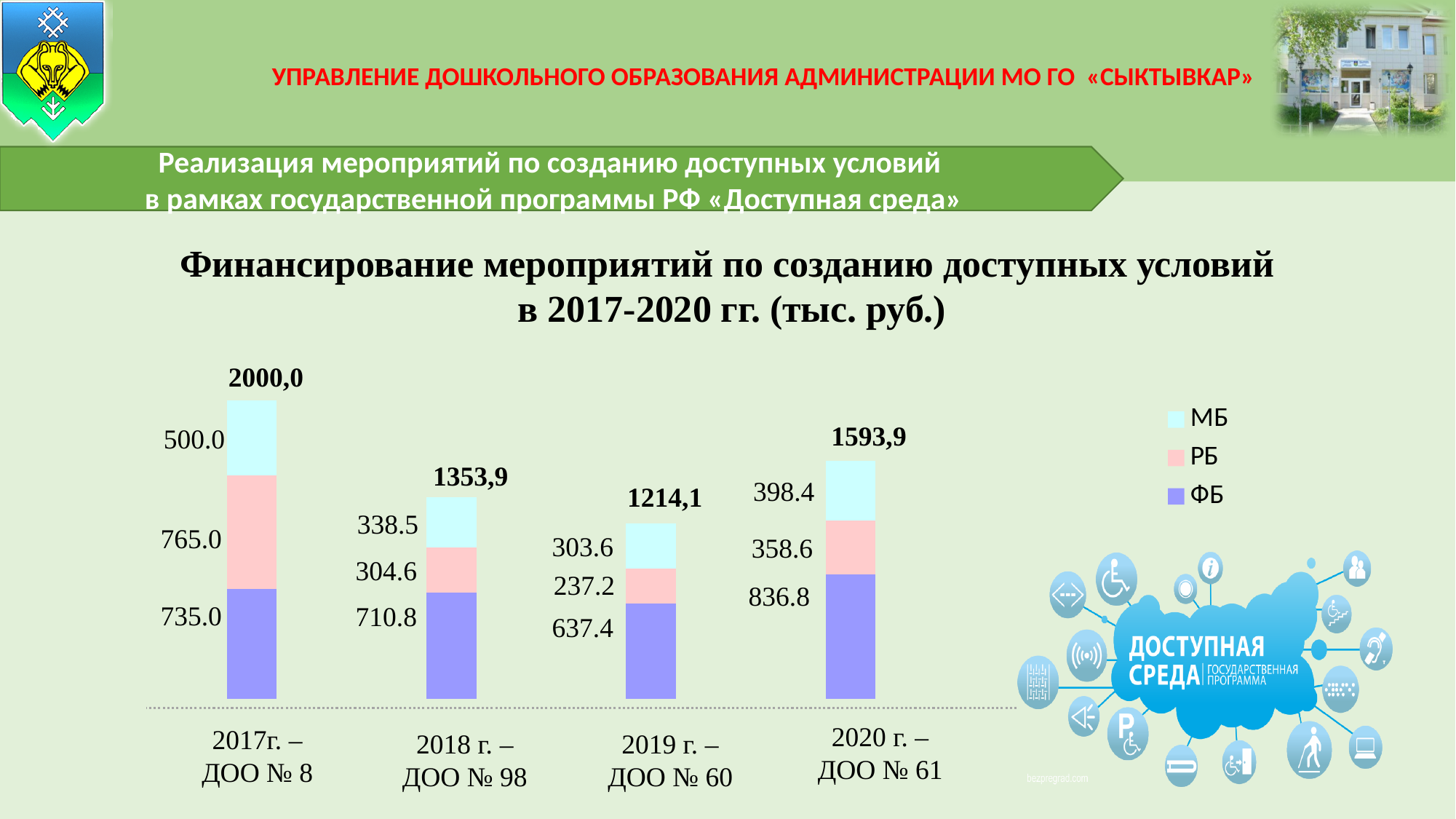
Which is larger: the РБ value for 2017 г. – ДОО № 8 or the РБ value for 2020 г. – ДОО № 61? 2017 г. – ДОО № 8 What type of chart is shown on the slide? Stacked bar chart How many series does the legend list? 3 Which year has the highest total funding? 2017 г. – ДОО № 8 What is the difference between the ФБ values for 2020 г. – ДОО № 61 and 2019 г. – ДОО № 60? 199.4 What is the РБ value for 2019 г. – ДОО № 60? 237.2 How many bars (years) are shown in the chart? 4 Which legend entry is shown in light blue? МБ What is the total of the stacked bar for 2020 г. – ДОО № 61? 1593,9 Which year has the lowest total funding? 2019 г. – ДОО № 60 What is the МБ value for 2018 г. – ДОО № 98? 338.5 What is the ФБ value for 2017 г. – ДОО № 8? 735.0